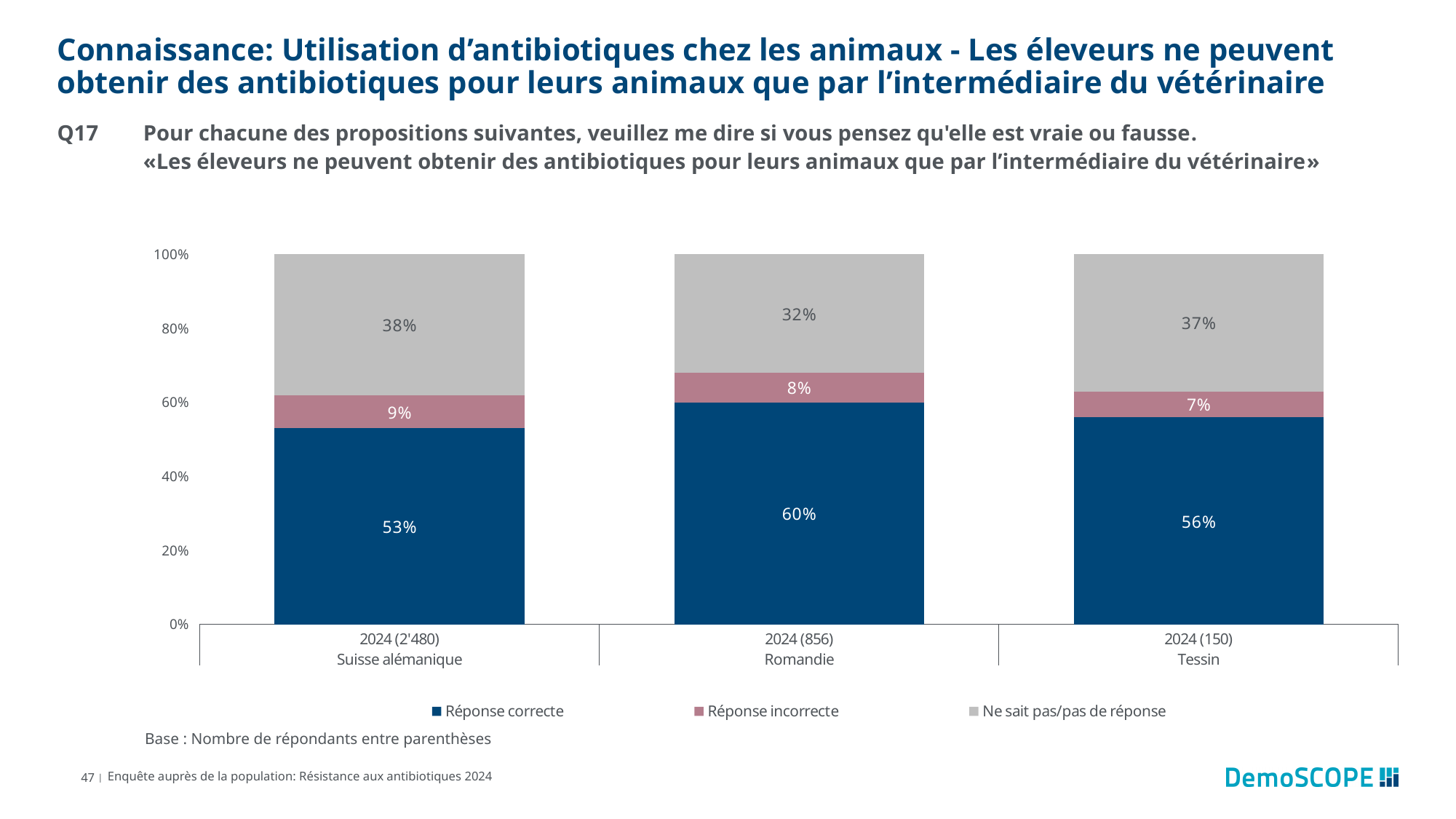
What is the value of 'Réponse correcte' for Romandie? 60% What is the number of respondents shown for Romandie? 856 Which is larger: 'Réponse incorrecte' for Suisse alémanique or for Romandie? Suisse alémanique What kind of chart is shown on the slide? Stacked bar chart Which region has the lowest value for 'Ne sait pas/pas de réponse'? Romandie How many series does the legend list? 3 What is the value of 'Ne sait pas/pas de réponse' for Suisse alémanique? 38% What is the difference between the 'Réponse correcte' values for Romandie and Suisse alémanique? 7% Is the value of 'Réponse correcte' for Tessin greater or less than 40%? greater How many regions are shown on the x axis? 3 What is the value of 'Réponse incorrecte' for Tessin? 7% Which region has the highest value for 'Réponse correcte'? Romandie